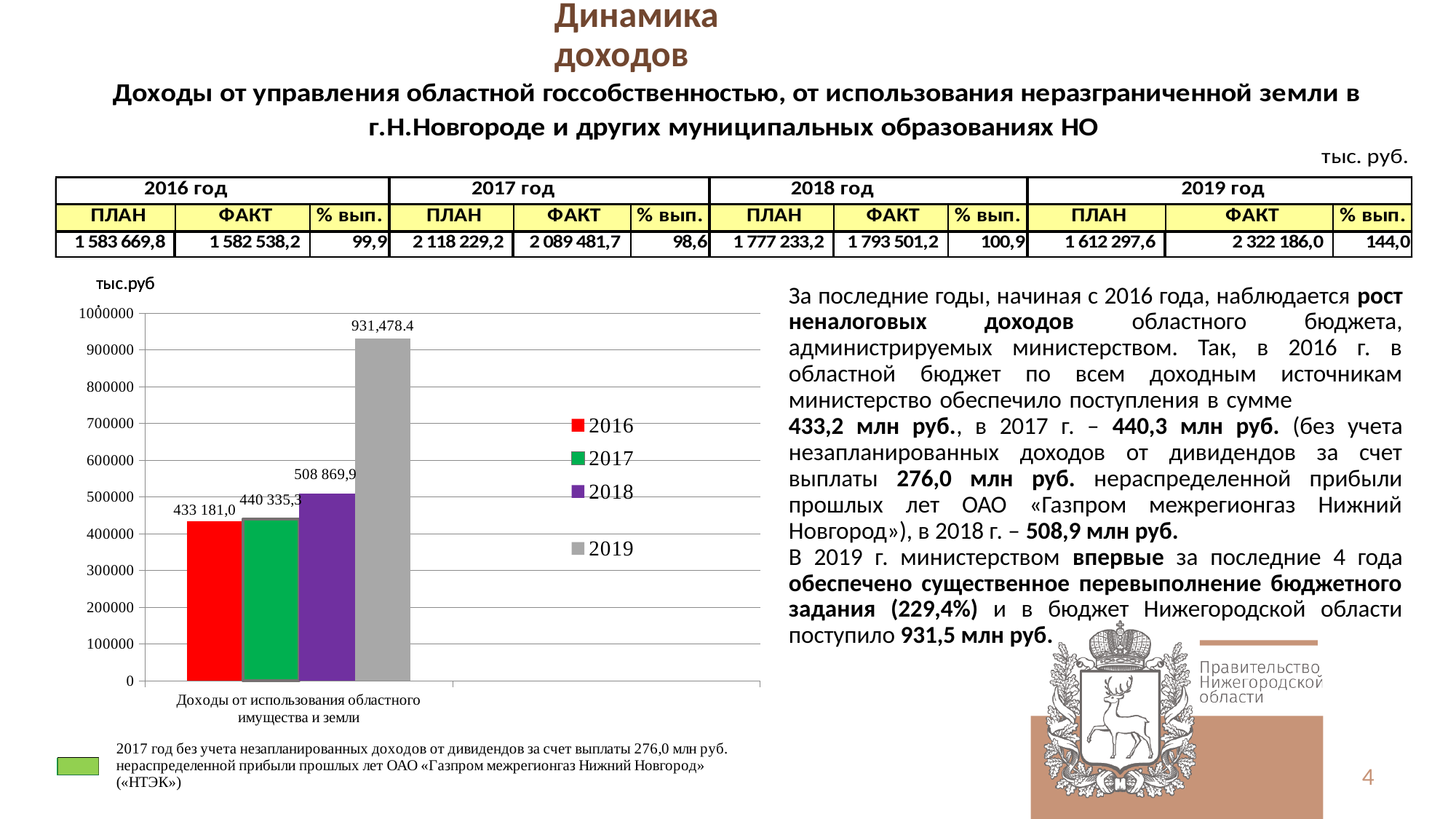
What type of chart is shown on the slide? bar chart Which year has the highest bar in the chart? 2019 What is the value of the 2018 bar in the chart? 508 869,9 What colour is the 2019 bar in the chart? grey How many series does the chart legend list? 4 What is the value of the 2016 bar in the chart? 433 181,0 Which year has the lowest bar in the chart? 2016 What is the value of the 2019 bar in the chart? 931,478.4 Which is larger in the chart, the 2018 bar or the 2017 bar? 2018 Do the bar values rise or fall from 2016 to 2019? rise What is the value of the 2017 bar in the chart? 440 335,3 Is the value for 2019 greater or less than 900000? greater